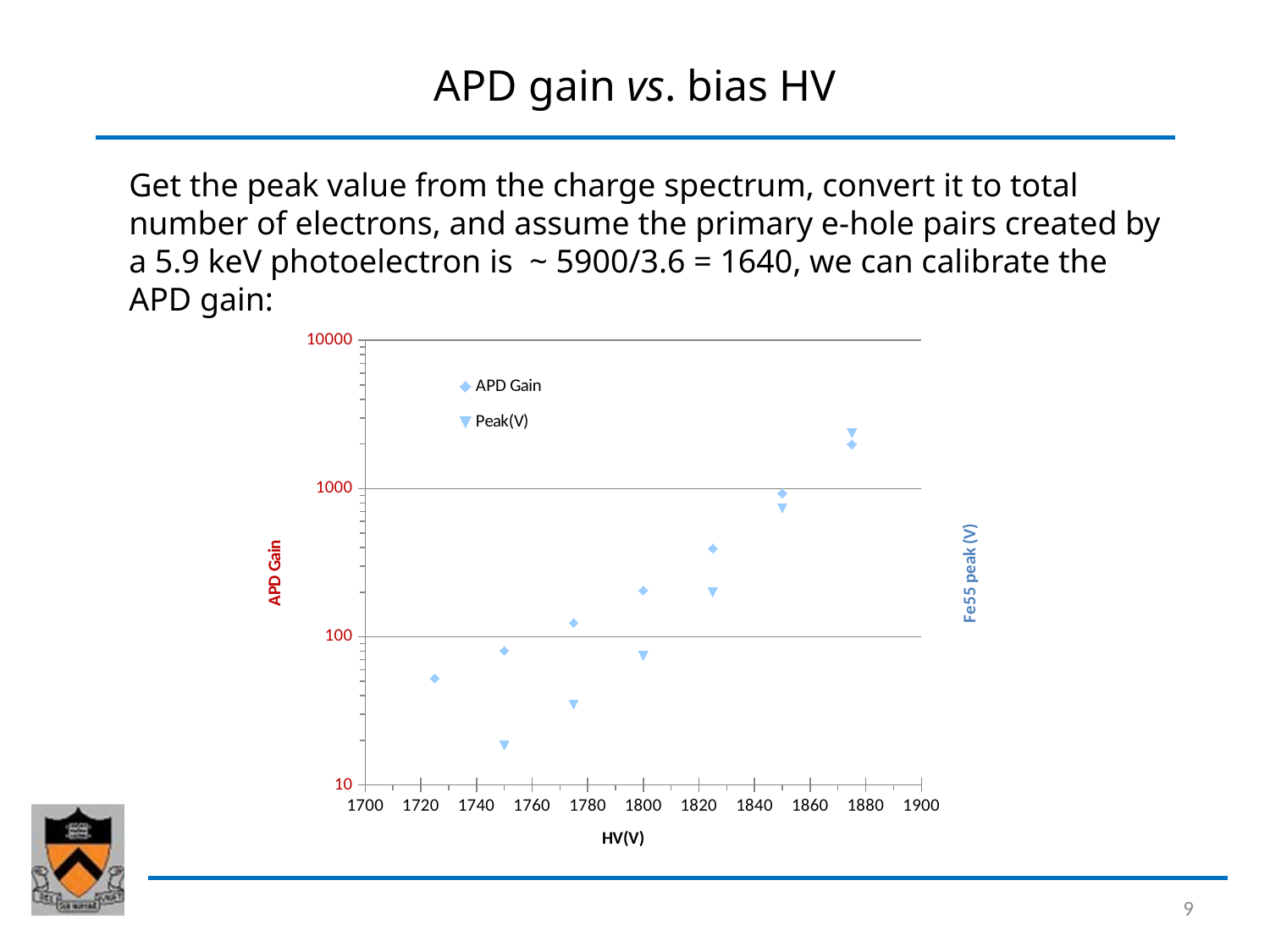
At HV 1775, which is larger: the APD Gain value or the Peak(V) value? APD Gain At which HV value is the Peak(V) lowest? 1750 What is the title of the x axis of the chart? HV(V) How many Peak(V) data points are plotted on the chart? 6 How many series does the chart legend list? 2 What kind of chart is shown on the slide? scatter chart At which HV value is the APD Gain highest? 1875 How many APD Gain data points are plotted on the chart? 7 Do the APD Gain values rise or fall as HV increases along the x axis? rise Is the APD Gain value at HV 1725 greater or less than 100? less What are the two series named in the chart legend? APD Gain and Peak(V)